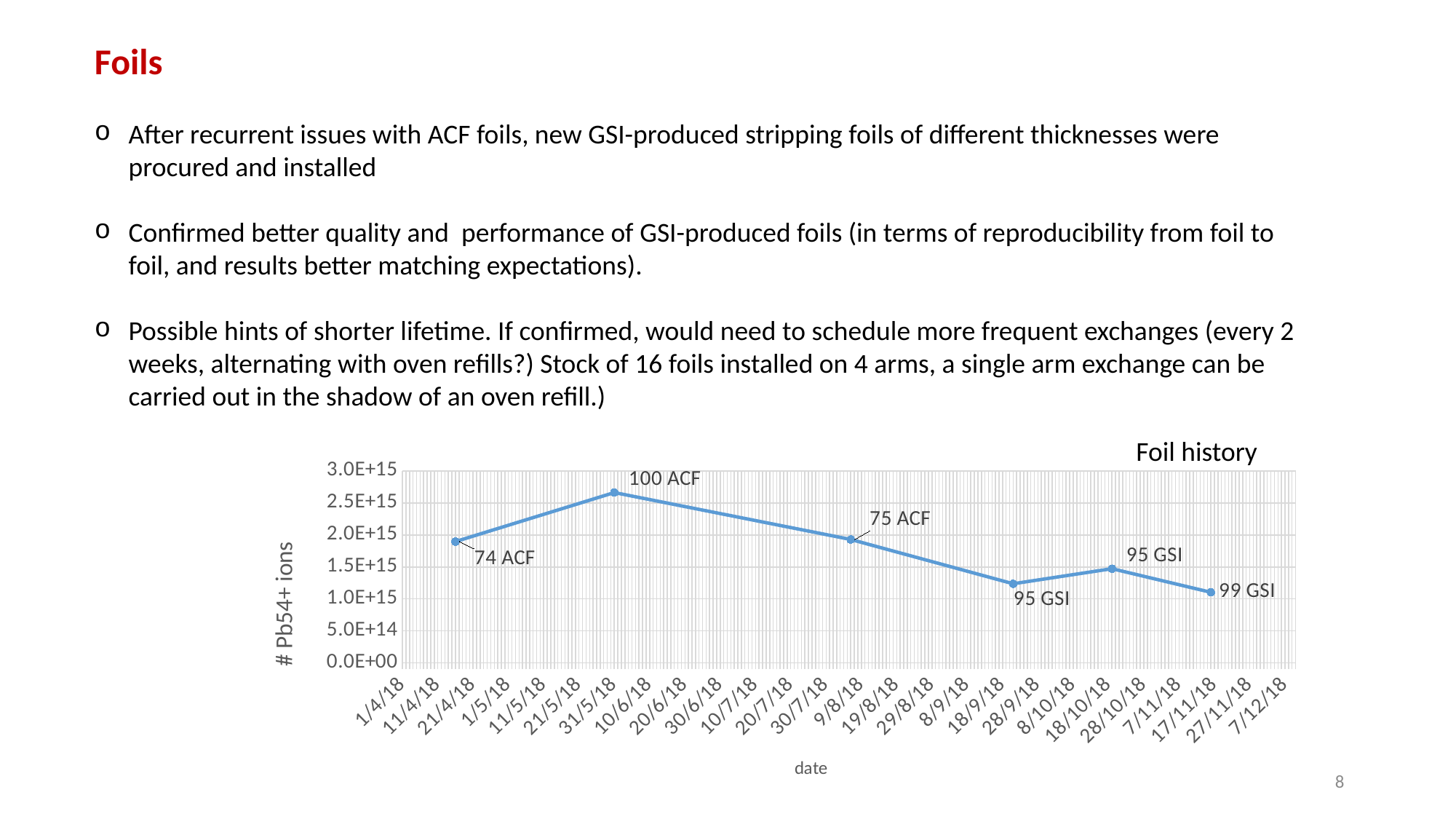
Which has the larger value, 100 ACF or 75 ACF? 100 ACF Which labelled point has the lowest value on the chart? 99 GSI What kind of chart is shown on the slide? line chart Is the value for 74 ACF greater or less than 1.5E+15? greater Which labelled point has the highest value on the chart? 100 ACF What is the title of the chart? Foil history Is the value for 100 ACF greater or less than 2.5E+15? greater Is the value for 99 GSI greater or less than 1.5E+15? less What is the label of the y axis of the chart? # Pb54+ ions Do the values rise or fall from the 100 ACF point to the first 95 GSI point? fall How many data points are plotted on the chart? 6